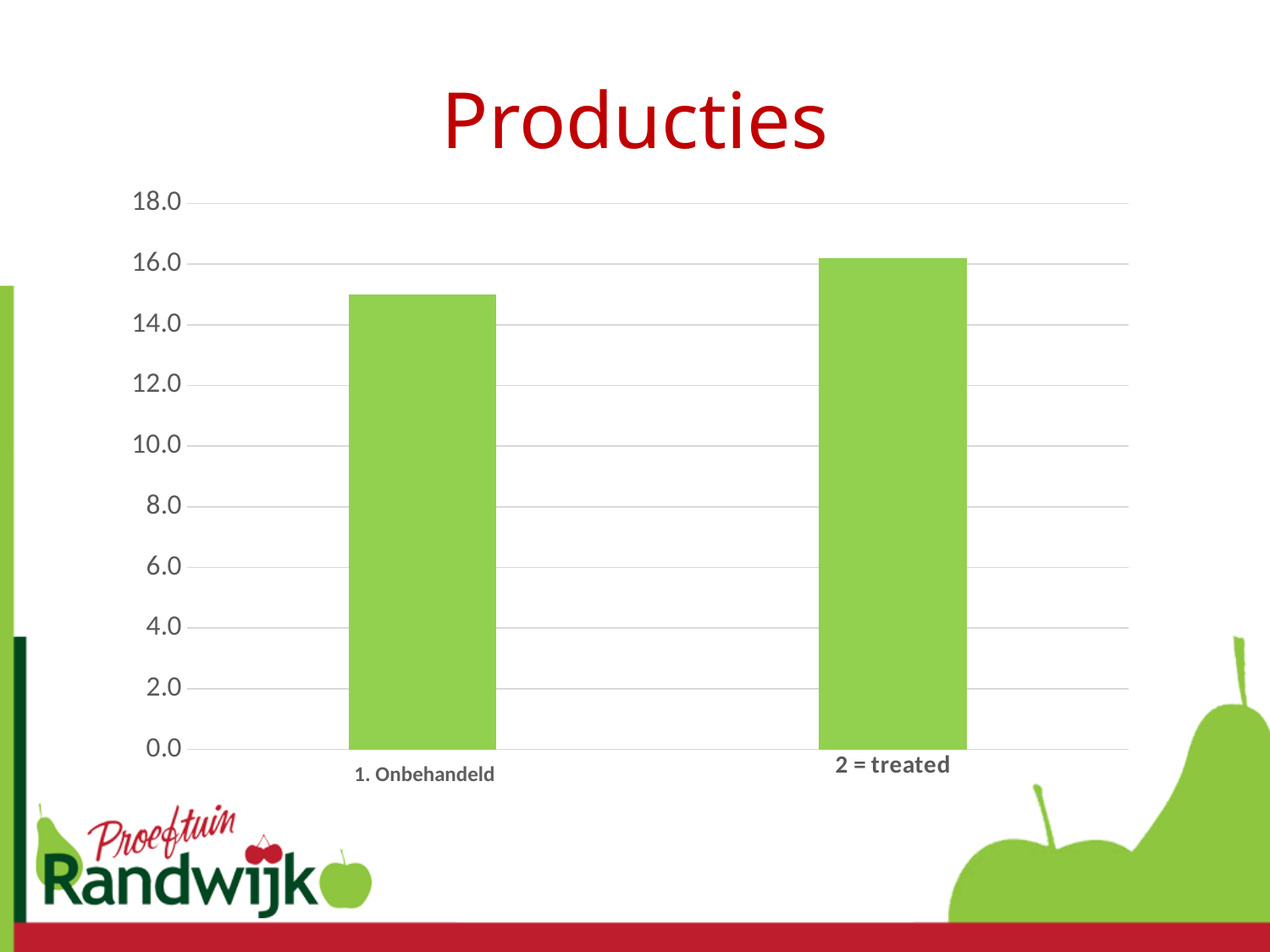
Which category has the highest bar? 2 = treated Which is larger, the value for 1. Onbehandeld or the value for 2 = treated? 2 = treated Is the value for 1. Onbehandeld greater or less than 14.0? greater Is the value for 2 = treated greater or less than 14.0? greater What kind of chart is shown on the slide? bar chart Is the value for 2 = treated greater or less than 18.0? less What is the highest value shown on the vertical axis? 18.0 How many bars are plotted in the chart? 2 What is the title of the chart on the slide? Producties Which category has the lowest bar? 1. Onbehandeld Do the bar values rise or fall from left to right along the x axis? rise